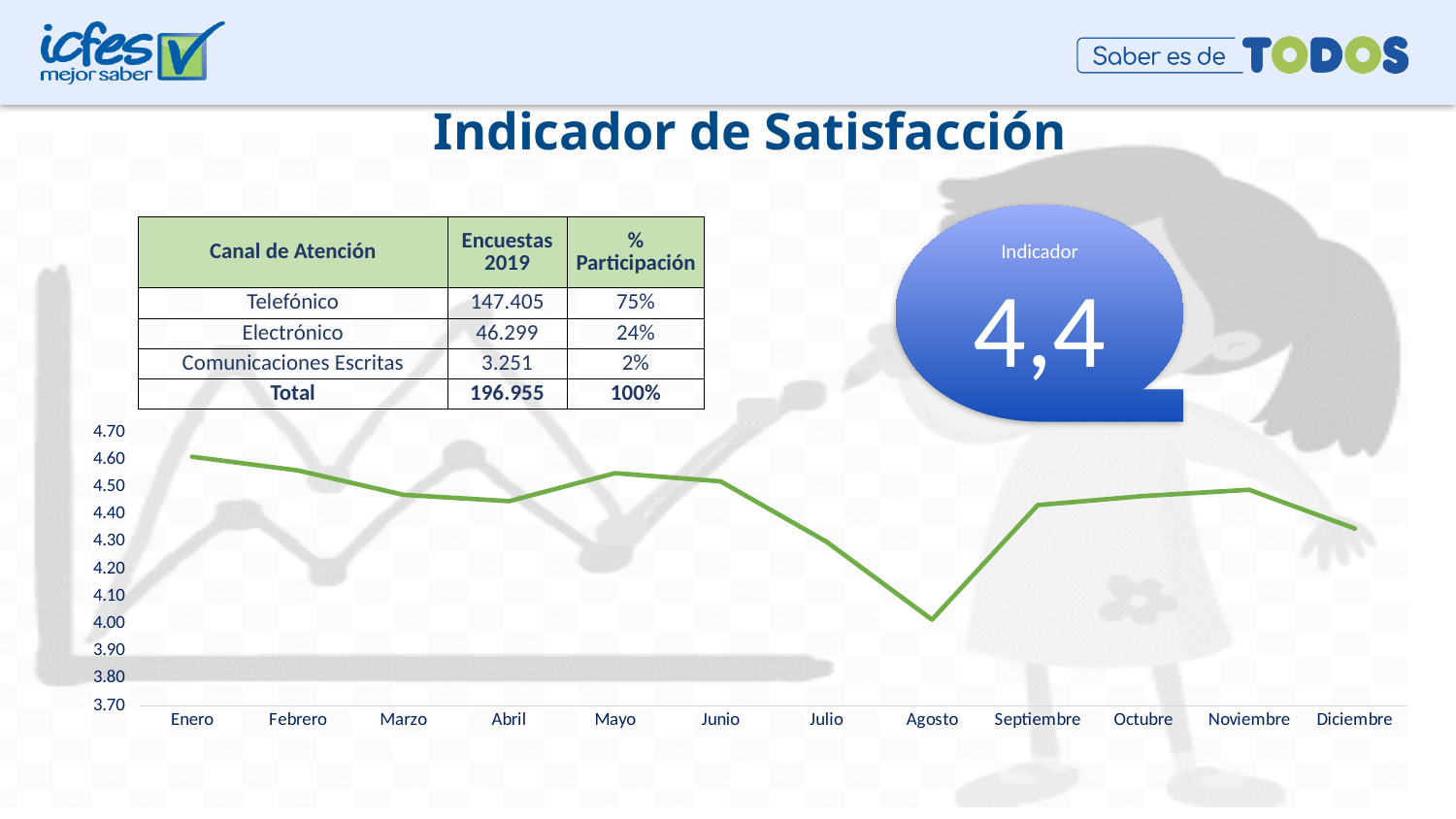
Is the value for Enero greater or less than 4.50? greater Which month has the lowest value in the line chart? Agosto What kind of chart is shown on the slide? line chart Which month has the highest value in the line chart? Enero Do the values rise or fall from Agosto to Noviembre? rise Which is larger, the value for Abril or the value for Agosto? Abril Which is larger, the value for Mayo or the value for Julio? Mayo What is the lowest tick value shown on the y axis of the line chart? 3.70 Is the value for Diciembre greater or less than 4.20? greater Is the value for Agosto greater or less than 4.10? less How many months are plotted along the x axis of the line chart? 12